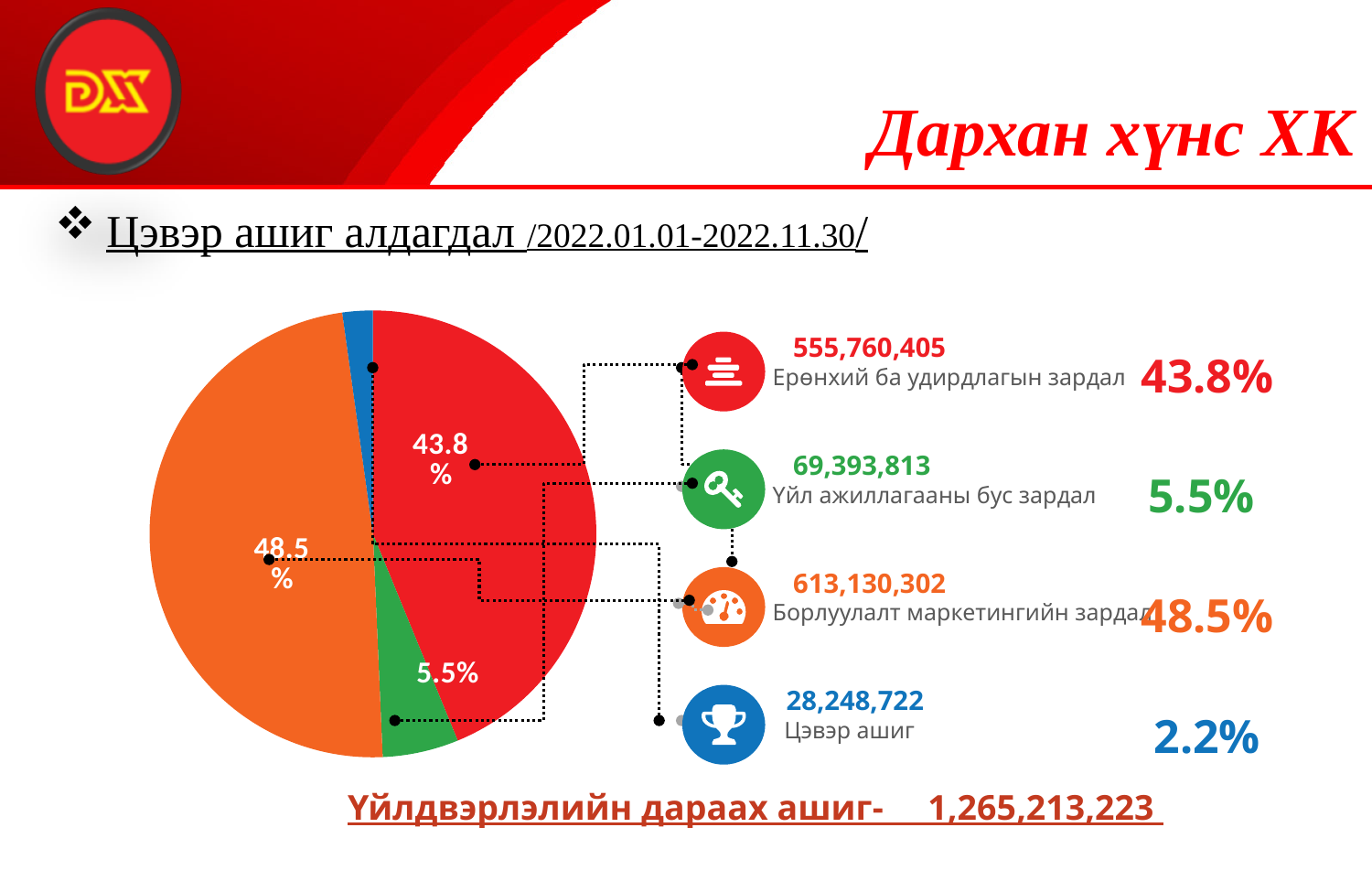
What is the value shown for Ерөнхий ба удирдлагын зардал? 555,760,405 What share of the pie does Цэвэр ашиг represent? 2.2% What share of the pie does Үйл ажиллагааны бус зардал represent? 5.5% Which category has the smallest share of the pie? Цэвэр ашиг Which category has the largest share of the pie? Борлуулалт маркетингийн зардал What is the value shown for Цэвэр ашиг? 28,248,722 What is the difference in percentage points between the Борлуулалт маркетингийн зардал slice and the Ерөнхий ба удирдлагын зардал slice? 4.7% What share of the pie does Ерөнхий ба удирдлагын зардал represent? 43.8% What is the value shown for Борлуулалт маркетингийн зардал? 613,130,302 What kind of chart is shown on the slide? pie chart How many slices does the pie chart have? 4